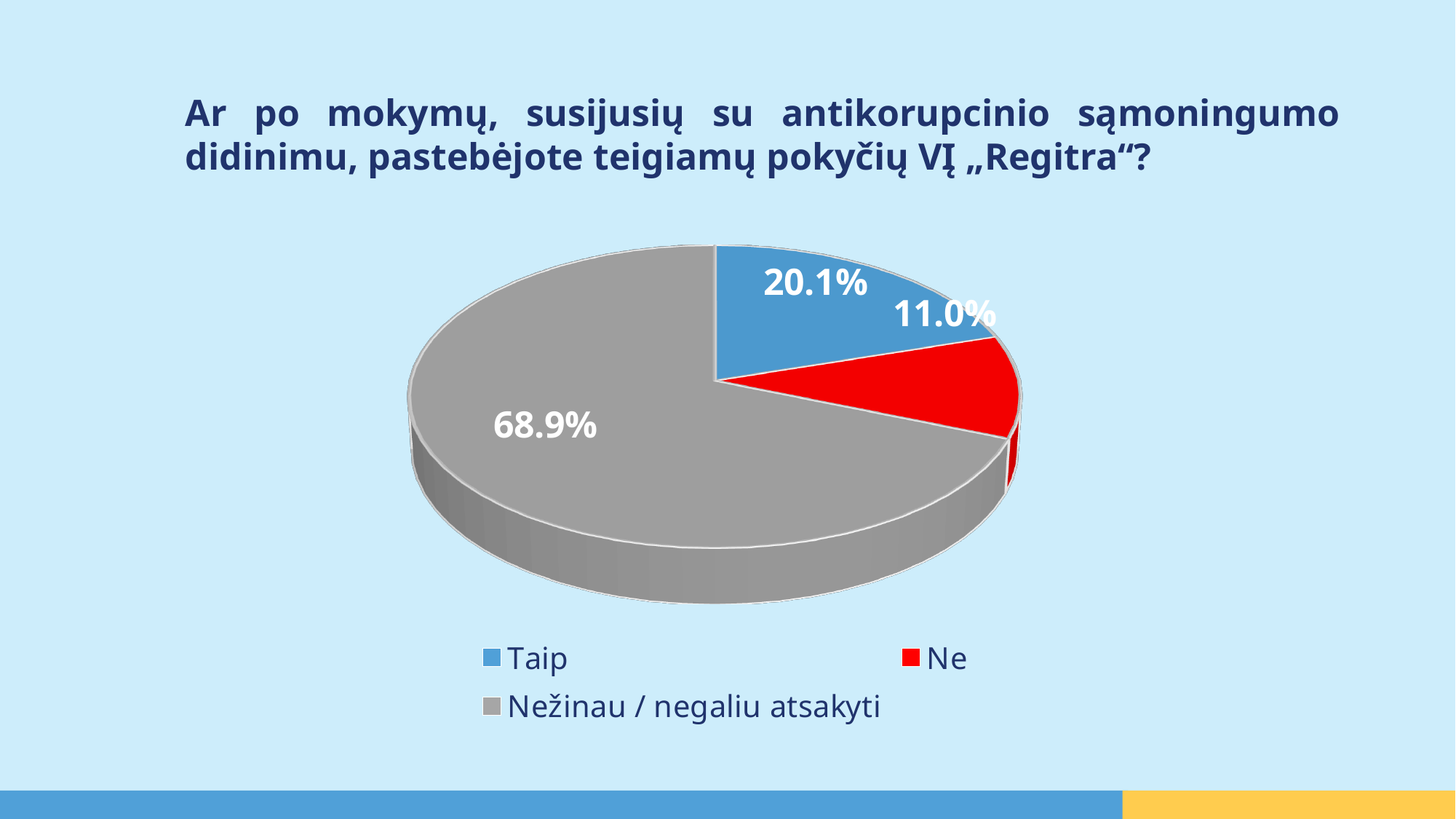
What kind of chart is shown on the slide? Pie chart What colour is the slice for "Ne"? Red What is the difference in percentage points between "Taip" and "Ne"? 9.1 Which answer option has the largest share of the pie? Nežinau / negaliu atsakyti Which answer option has the smallest share of the pie? Ne What percentage of respondents answered "Taip"? 20.1% How many slices does the pie chart have? 3 Which is larger, the share for "Taip" or the share for "Ne"? Taip How many entries does the legend list? 3 What percentage of respondents answered "Ne"? 11.0% What is the difference in percentage points between "Nežinau / negaliu atsakyti" and "Taip"? 48.8 What percentage of respondents answered "Nežinau / negaliu atsakyti"? 68.9%